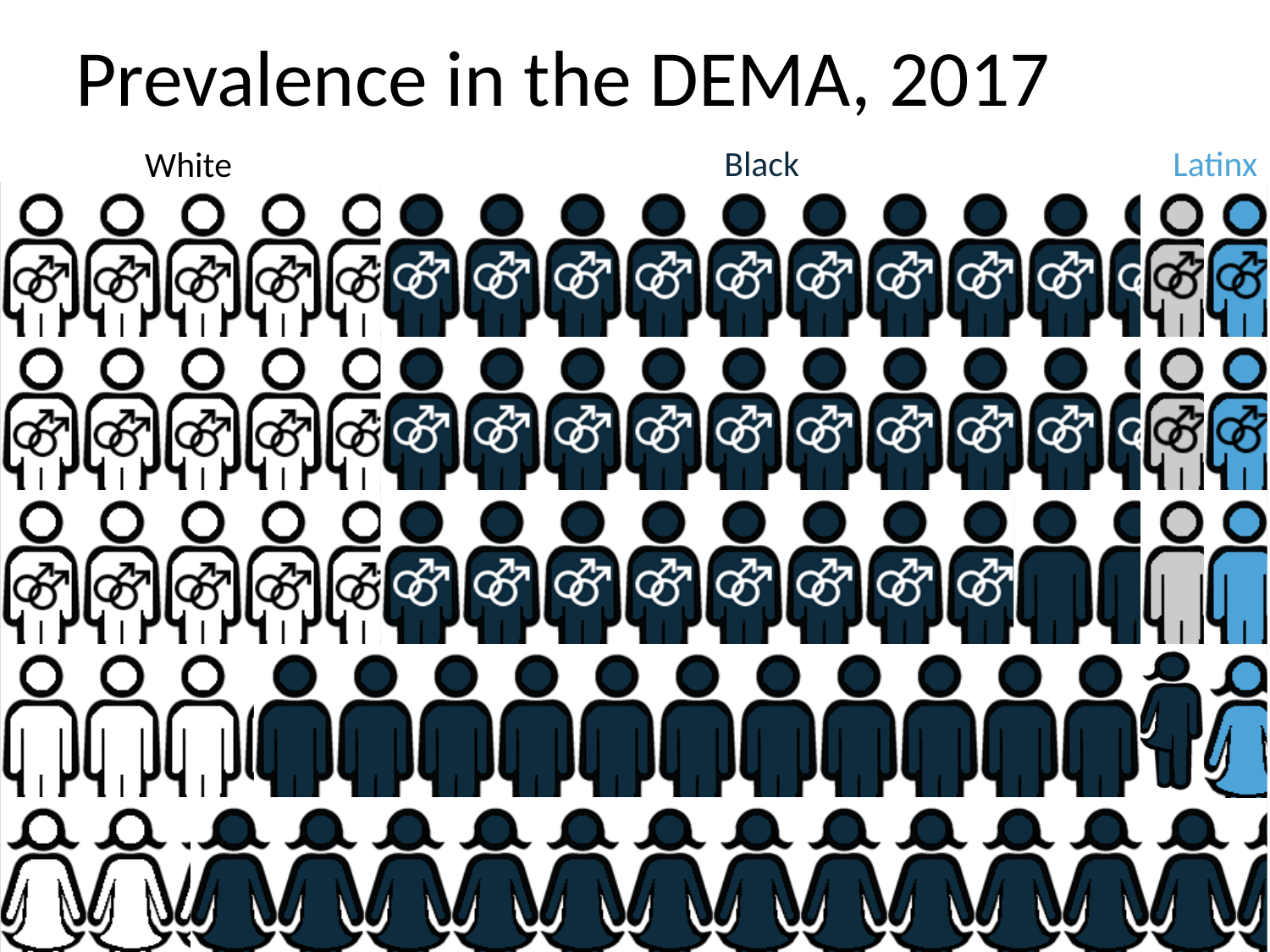
How many groups are labelled in the chart? 3 What kind of chart is shown on the slide? pictogram (icon array) Which group has more person icons, Black or White? Black Which group is represented by the largest number of person icons? Black Which group is represented by the smallest number of person icons? Latinx Which groups are labelled across the top of the chart? White, Black, Latinx What is the title of the chart on the slide? Prevalence in the DEMA, 2017 Which group has more person icons, White or Latinx? White What colour are the icons representing the Latinx group? light blue